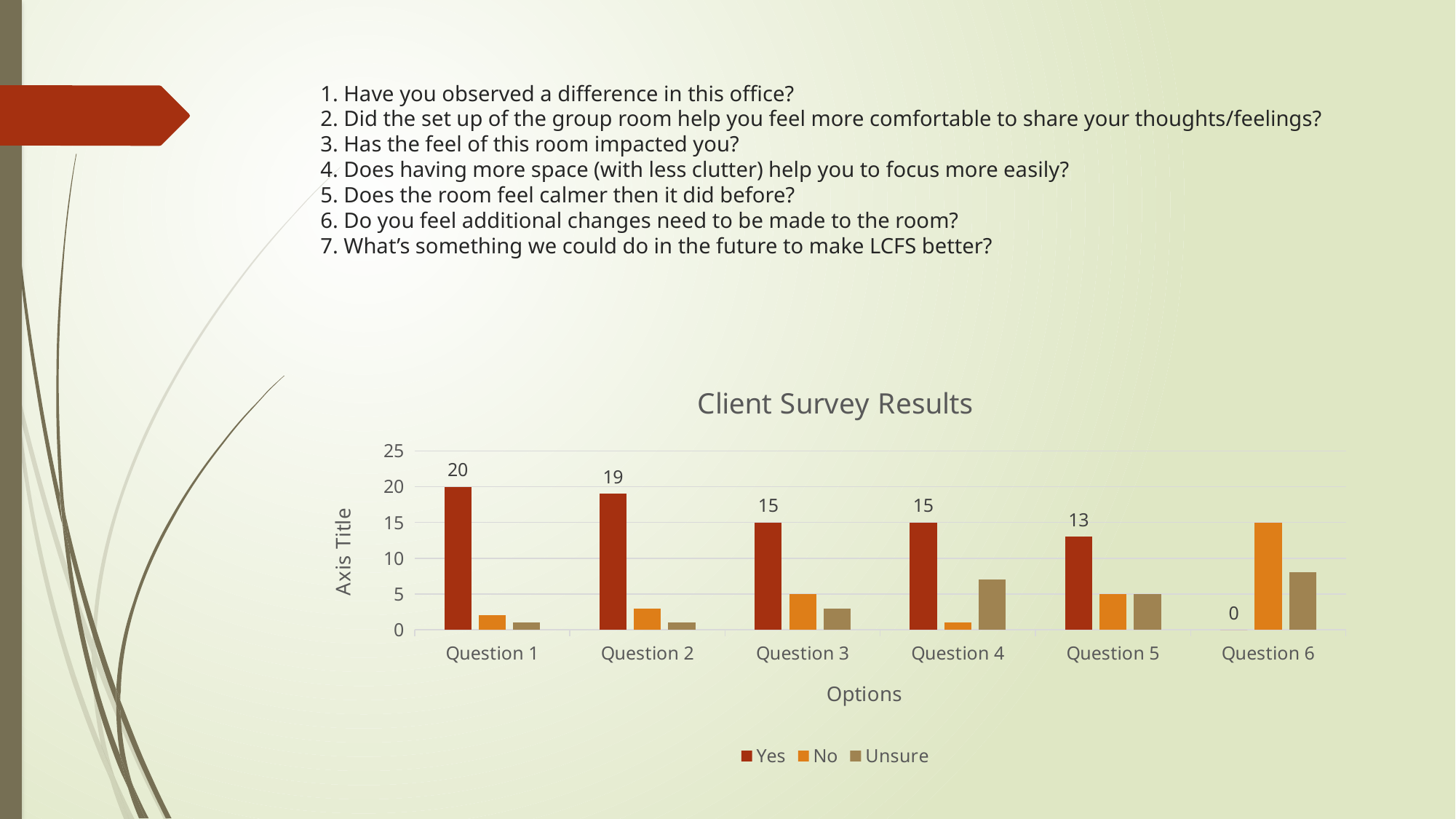
Is the No value for Question 6 greater or less than 10? greater Which question has the highest Yes value? Question 1 What type of chart is shown on the slide? bar chart How many series does the legend list? 3 What is the difference between the Yes values for Question 1 and Question 5? 7 Is the Unsure value for Question 4 greater or less than 5? greater What is the title of the chart? Client Survey Results What is the Yes value for Question 1? 20 Which question has the lowest Yes value? Question 6 What is the Yes value for Question 5? 13 What is the Yes value for Question 6? 0 How many question categories are shown on the x axis? 6